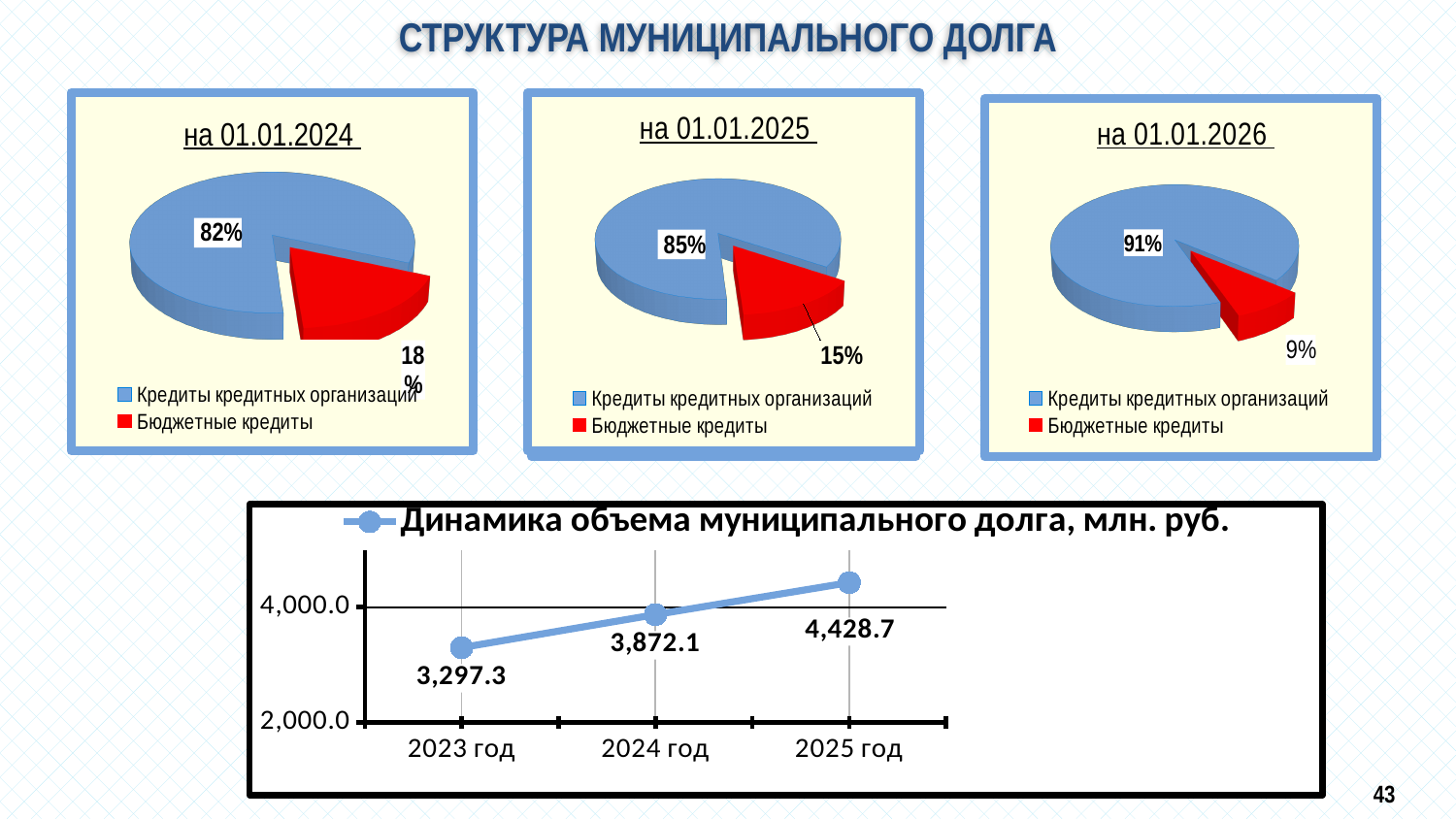
What type of chart is the chart at the bottom of the slide? line chart In the pie chart 'на 01.01.2026', what share is labelled for Бюджетные кредиты? 9% In the line chart 'Динамика объема муниципального долга, млн. руб.', which year has the lowest value? 2023 год In the line chart 'Динамика объема муниципального долга, млн. руб.', do the values rise or fall from 2023 год to 2025 год? rise In the line chart 'Динамика объема муниципального долга, млн. руб.', what is the difference between the values for 2025 год and 2023 год? 1,131.4 In the pie chart 'на 01.01.2024', what share is labelled for Бюджетные кредиты? 18% In the pie chart 'на 01.01.2025', what share is labelled for Кредиты кредитных организаций? 85% In the pie chart 'на 01.01.2026', which category has the largest slice? Кредиты кредитных организаций In the line chart 'Динамика объема муниципального долга, млн. руб.', what is the value for 2024 год? 3,872.1 In the line chart 'Динамика объема муниципального долга, млн. руб.', what is the value for 2025 год? 4,428.7 In the line chart 'Динамика объема муниципального долга, млн. руб.', how many data points are plotted? 3 How many entries does the legend of the pie chart 'на 01.01.2024' list? 2